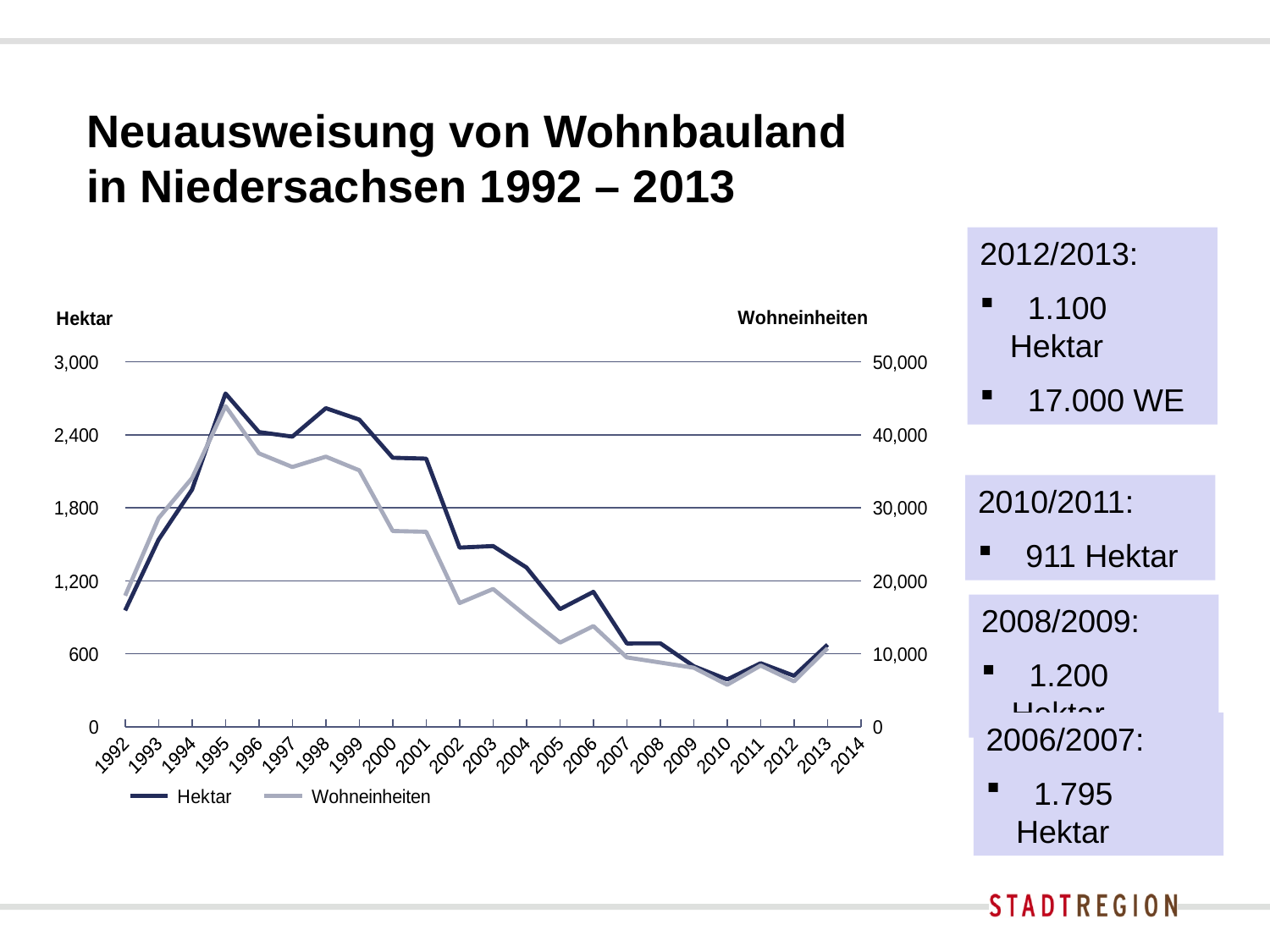
Which year has the larger Hektar value, 1998 or 2005? 1998 What kind of chart is shown on the slide? Line chart How many series does the chart legend list? 2 Is the Hektar value for 1995 greater or less than 2,400? greater In which year does the Wohneinheiten series reach its highest value? 1995 In which year does the Hektar series reach its highest value? 1995 What are the two series named in the chart legend? Hektar and Wohneinheiten What is the label of the right-hand vertical axis of the chart? Wohneinheiten Is the Wohneinheiten value for 2002 greater or less than 20,000? less Is the Hektar value for 1992 greater or less than 1,200? less Do the Hektar values generally rise or fall between 1995 and 2010? fall